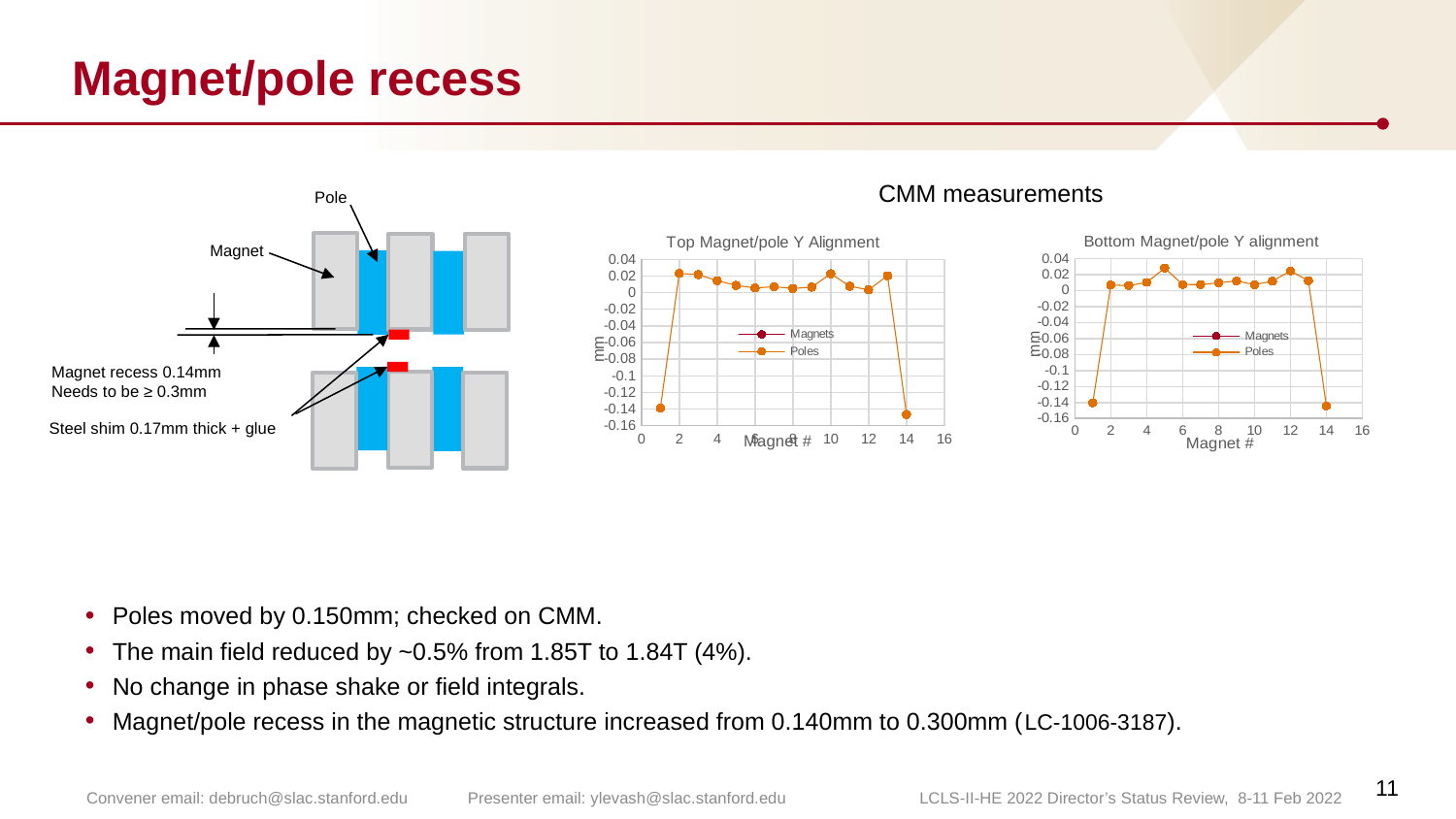
What kind of chart is the 'Top Magnet/pole Y Alignment' chart? line chart In the 'Top Magnet/pole Y Alignment' chart, is the value for magnet 1 greater or less than -0.1? less In the 'Bottom Magnet/pole Y alignment' chart, which magnet number has the highest value? 5 What are the two series named in the legend of the 'Top Magnet/pole Y Alignment' chart? Magnets and Poles In the 'Bottom Magnet/pole Y alignment' chart, which is larger, the value for magnet 1 or the value for magnet 6? magnet 6 How many data points are plotted in the 'Top Magnet/pole Y Alignment' chart? 14 In the 'Bottom Magnet/pole Y alignment' chart, is the value for magnet 14 greater or less than -0.1? less In the 'Top Magnet/pole Y Alignment' chart, which is larger, the value for magnet 2 or the value for magnet 14? magnet 2 How many series does the legend of the 'Bottom Magnet/pole Y alignment' chart list? 2 In the 'Top Magnet/pole Y Alignment' chart, is the value for magnet 5 greater or less than -0.04? greater What is the x-axis label of the 'Bottom Magnet/pole Y alignment' chart? Magnet #